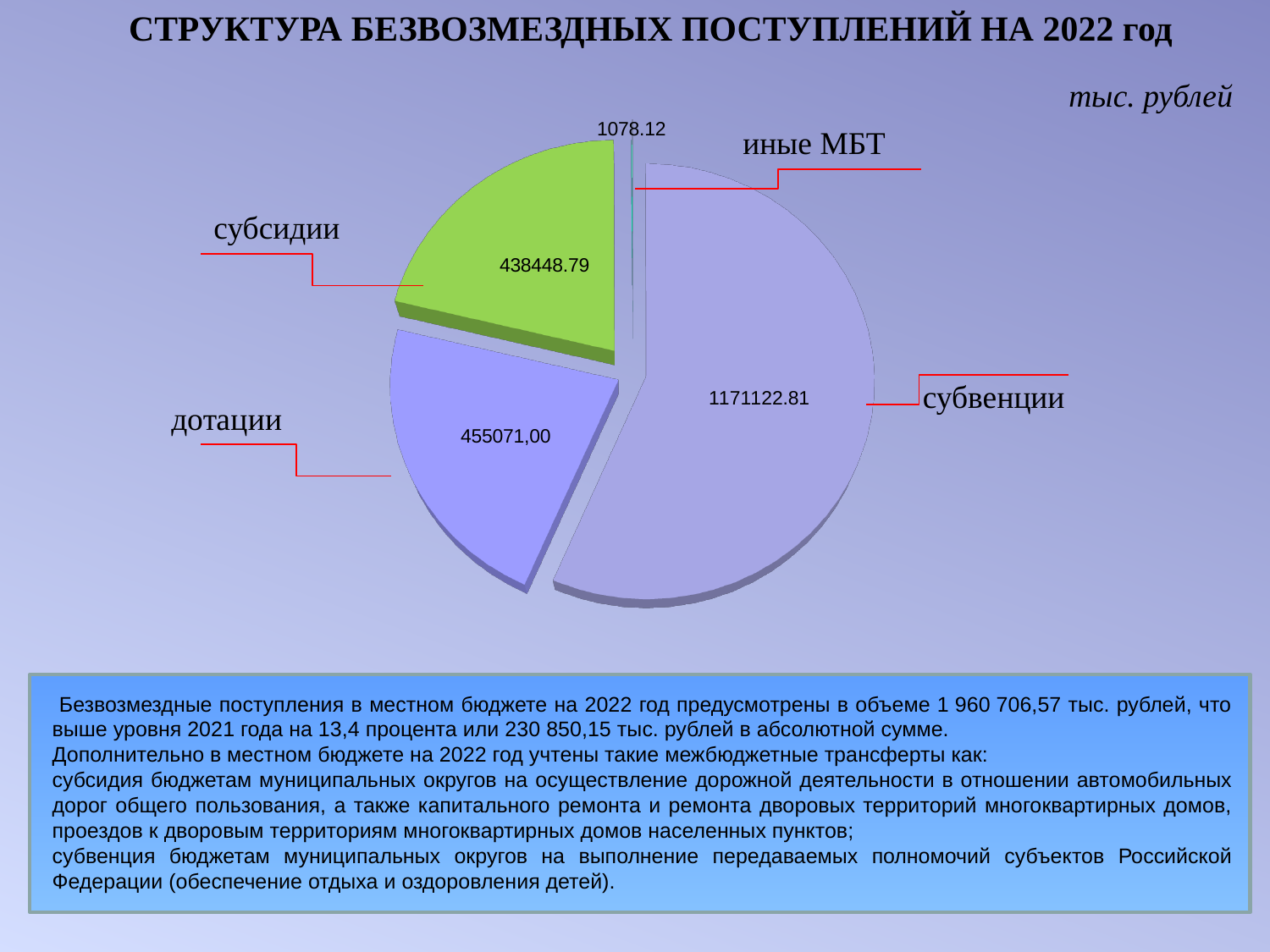
What is the value for иные МБТ? 1078.12 What is the value for субсидии? 438448.79 What is the difference between the values for субвенции and дотации? 716051.81 What is the value for субвенции? 1171122.81 What kind of chart is shown on the slide? pie chart Which category has the smallest slice of the pie? иные МБТ How many categories are shown in the pie chart? 4 Which category has the largest slice of the pie? субвенции In what units are the chart values given? тыс. рублей What is the difference between the values for дотации and субсидии? 16622.21 Which is larger, дотации or субсидии? дотации What is the value for дотации? 455071,00